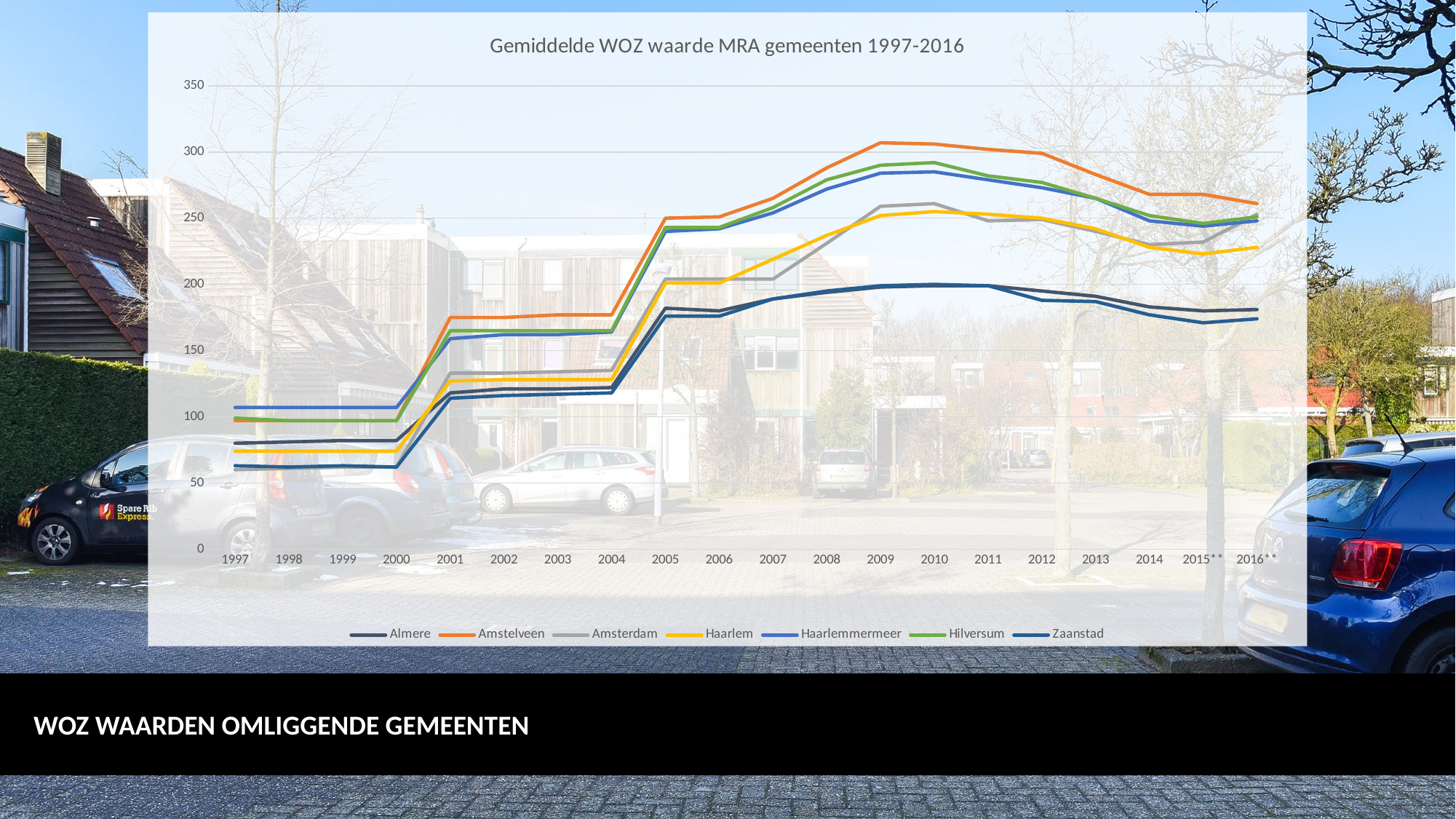
Which municipality has the lowest value in 2016**? Zaanstad Which is larger in 2009, the value for Amstelveen or the value for Zaanstad? Amstelveen How many years are shown along the x axis? 20 Is the value for Amsterdam in 2010 greater or less than 250? greater What kind of chart is shown on the slide? line chart What is the title of the chart? Gemiddelde WOZ waarde MRA gemeenten 1997-2016 Does the value for Amstelveen rise or fall between 1997 and 2009? rise Is the value for Amstelveen in 2009 greater or less than 300? greater Which municipality has the highest value in 2009? Amstelveen How many series does the legend list? 7 Is the value for Haarlem in 2016** greater or less than 250? less